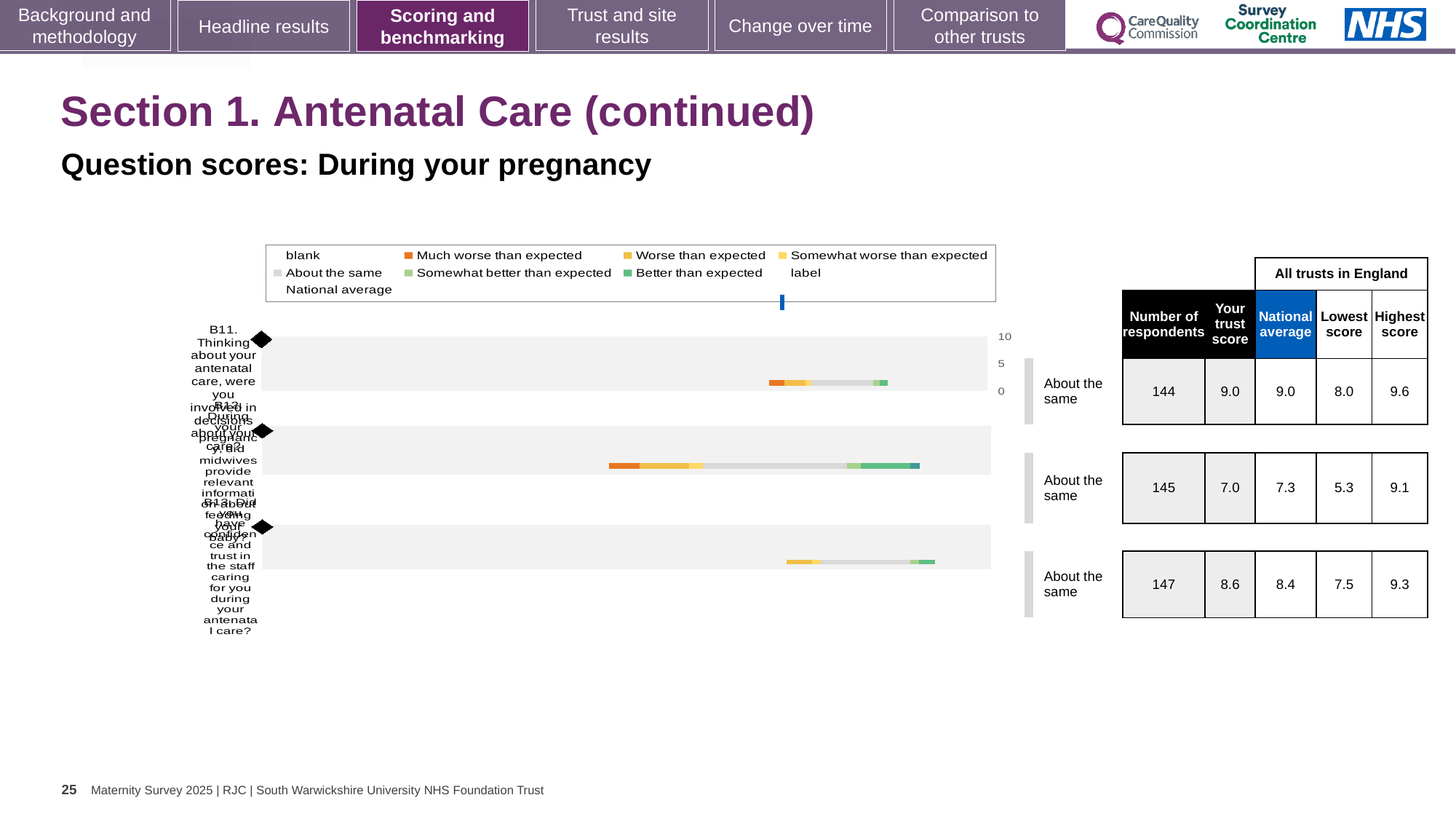
What is the number of respondents for question B13? 147 Which colour in the legend represents 'Much worse than expected'? orange Which question has the highest 'Your trust score'? B11 What is the 'Your trust score' for question B11? 9.0 How many questions (bars) are plotted in the chart? 3 What is the 'Your trust score' for question B12? 7.0 What is the highest tick value shown on the chart's score axis? 10 What kind of chart is shown on the slide? bar chart For question B13, which is larger: the trust score or the national average? the trust score (8.6) Which question has the lowest 'Your trust score'? B12 What is the national average for question B13? 8.4 What is the difference between the highest score and the lowest score for question B12? 3.8